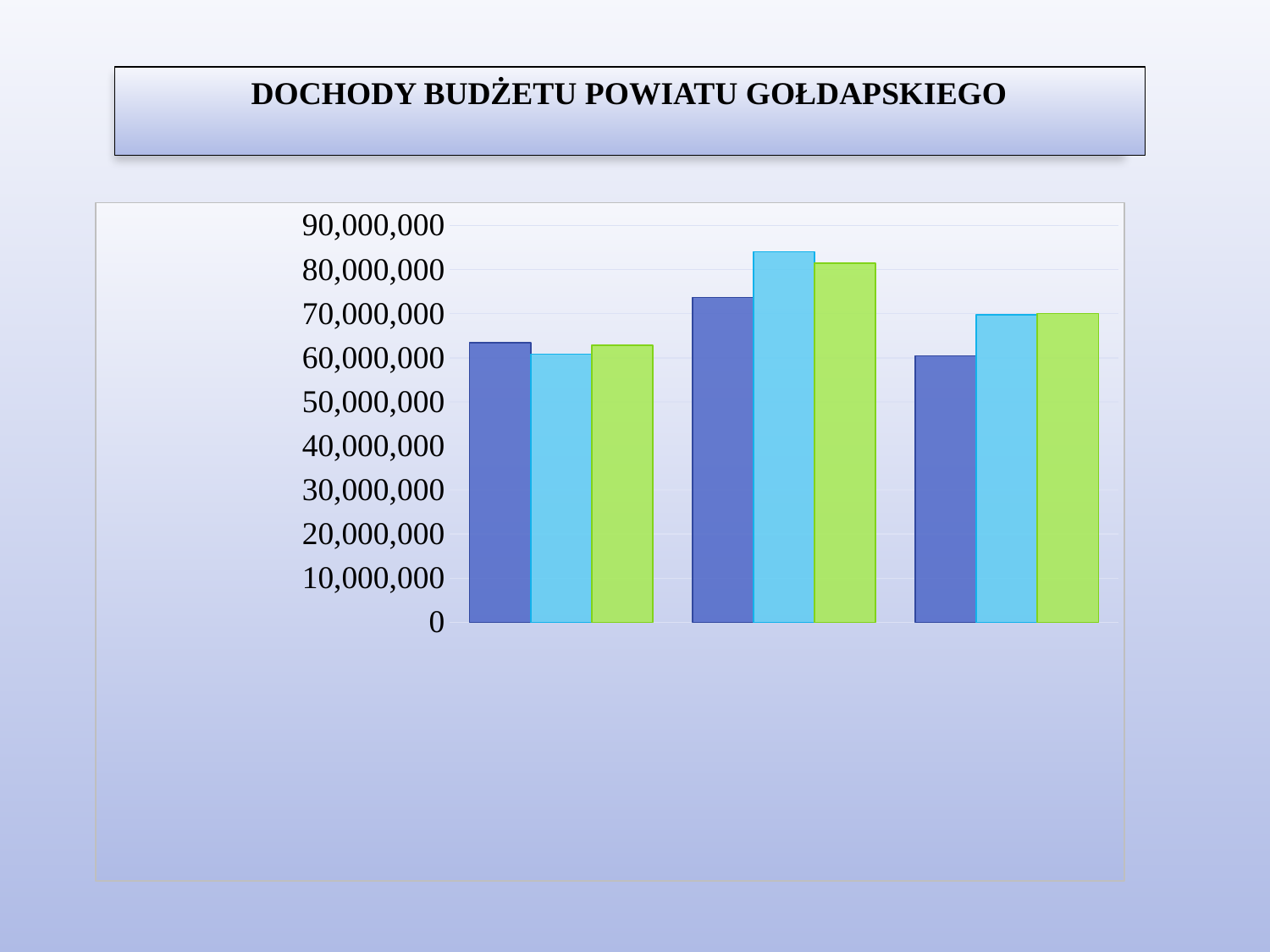
In the middle group, which bar is taller: the dark blue bar or the light blue bar? the light blue bar What kind of chart is shown on the slide? bar chart What is the title shown above the chart? DOCHODY BUDŻETU POWIATU GOŁDAPSKIEGO How many groups of bars does the chart show? 3 Is the value of the light blue bar in the middle group greater or less than 80,000,000? greater Which group of bars has the highest values overall: the left, middle or right group? the middle group How many bars are in each group of the chart? 3 Which bar is the tallest in the chart? the light blue bar in the middle group Is the value of the dark blue bar in the first (left) group greater or less than 60,000,000? greater Is the value of the green bar in the middle group greater or less than 90,000,000? less What is the highest value shown on the vertical axis? 90,000,000